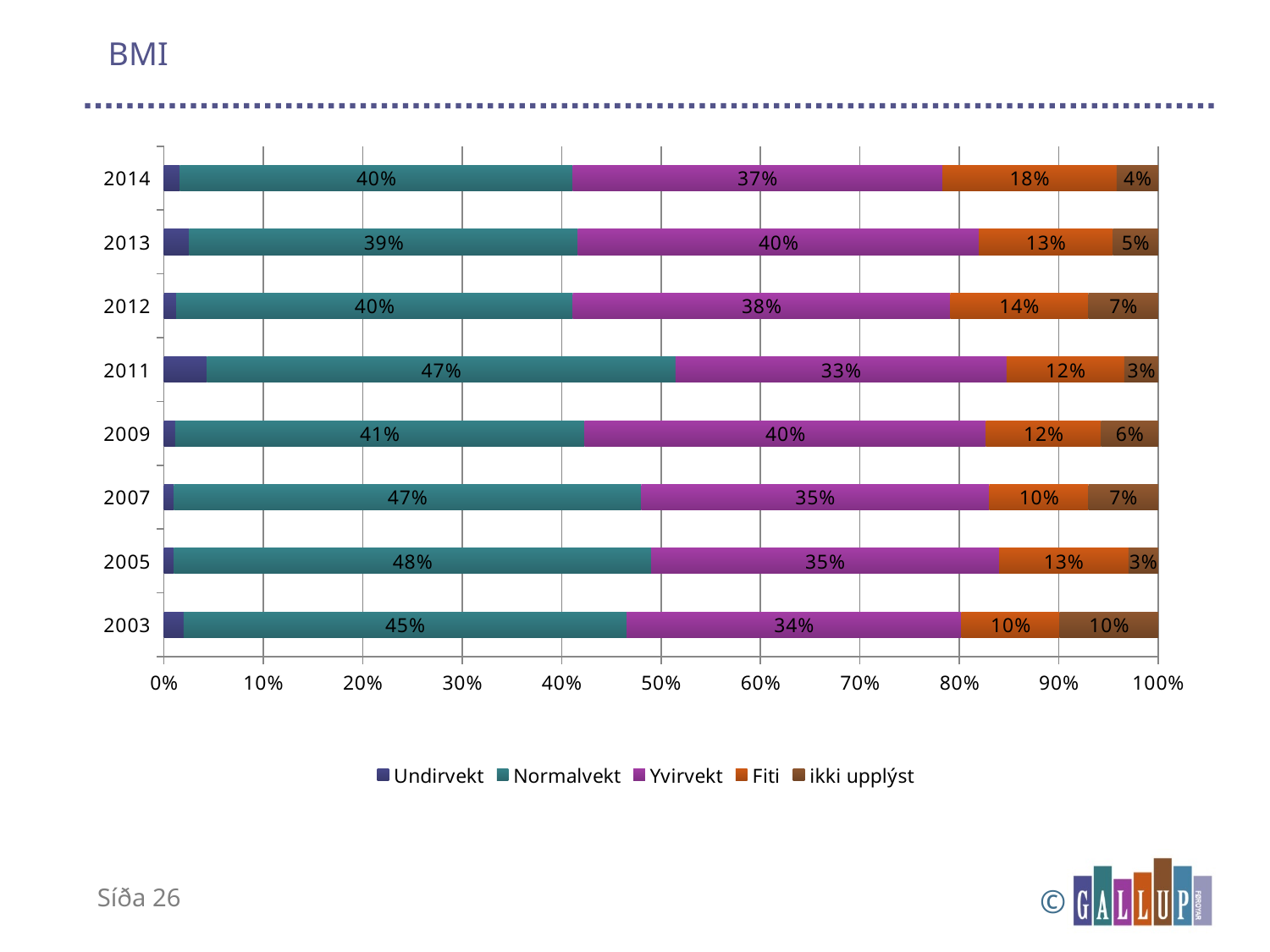
In which year is the Yvirvekt share lowest? 2011 What is the Yvirvekt value for 2011? 33% What is the Fiti value for 2003? 10% How many years are shown on the chart? 8 Which year has the larger Yvirvekt share, 2013 or 2014? 2013 In which year is the Fiti share highest? 2014 How many percentage points higher is Fiti in 2014 than in 2013? 5 percentage points In which year is the Normalvekt share highest? 2005 How many series does the legend list? 5 Is the Undirvekt value for 2011 greater or less than 10%? less What percentage is shown for Normalvekt in 2014? 40% What is the ikki upplýst value for 2012? 7%